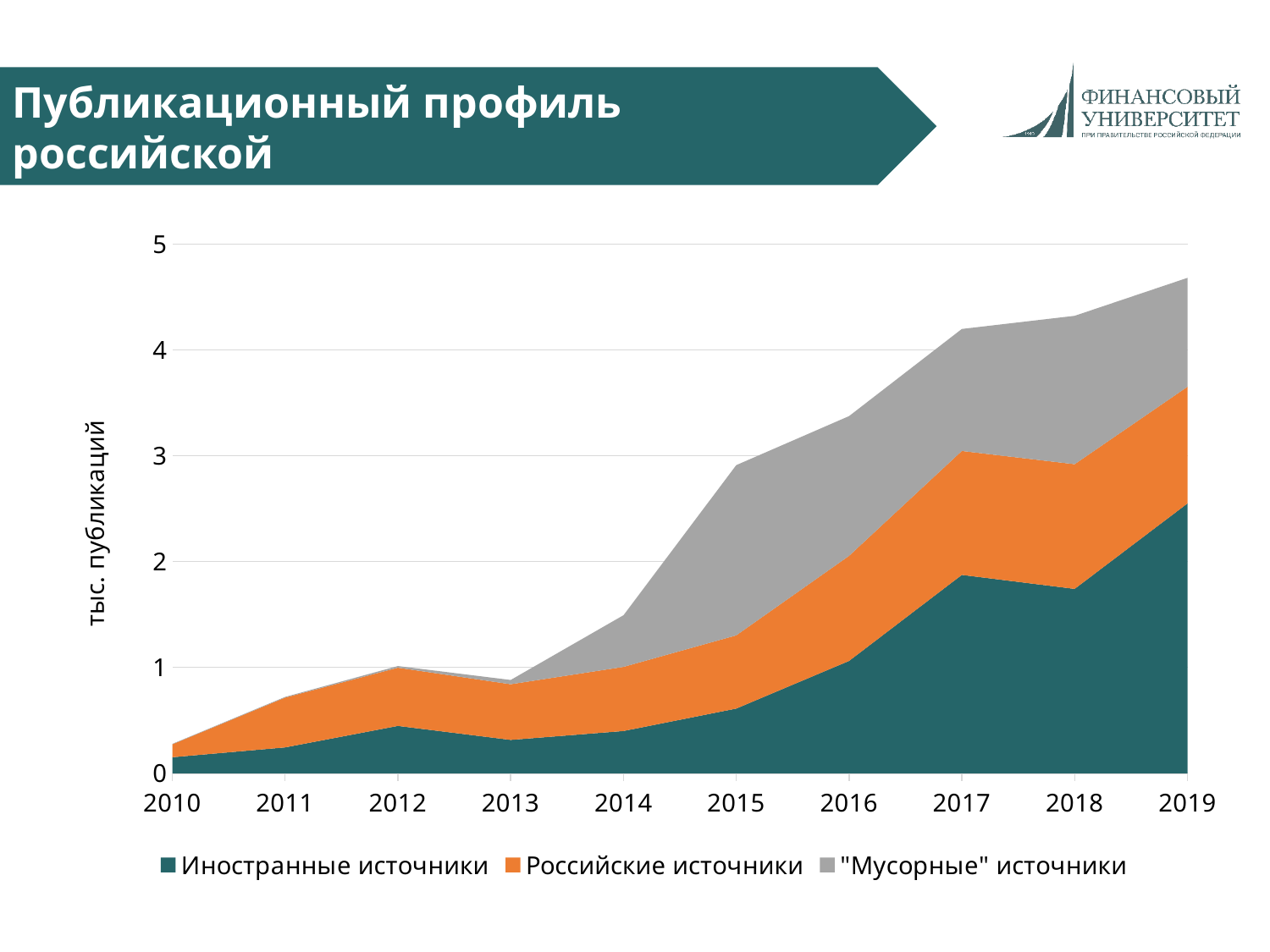
Is the total value for 2010 greater or less than 1? less How many series does the legend list? 3 Is the total value for 2019 greater or less than 4? greater Which year has the highest total number of publications? 2019 Does the total number of publications generally rise or fall from 2010 to 2019? Rise Is the value for Иностранные источники in 2019 greater or less than 2? greater What kind of chart is shown on the slide? Stacked area chart How many years are plotted along the x axis? 10 Which year has the lowest total number of publications? 2010 What is the label on the vertical axis? тыс. публикаций